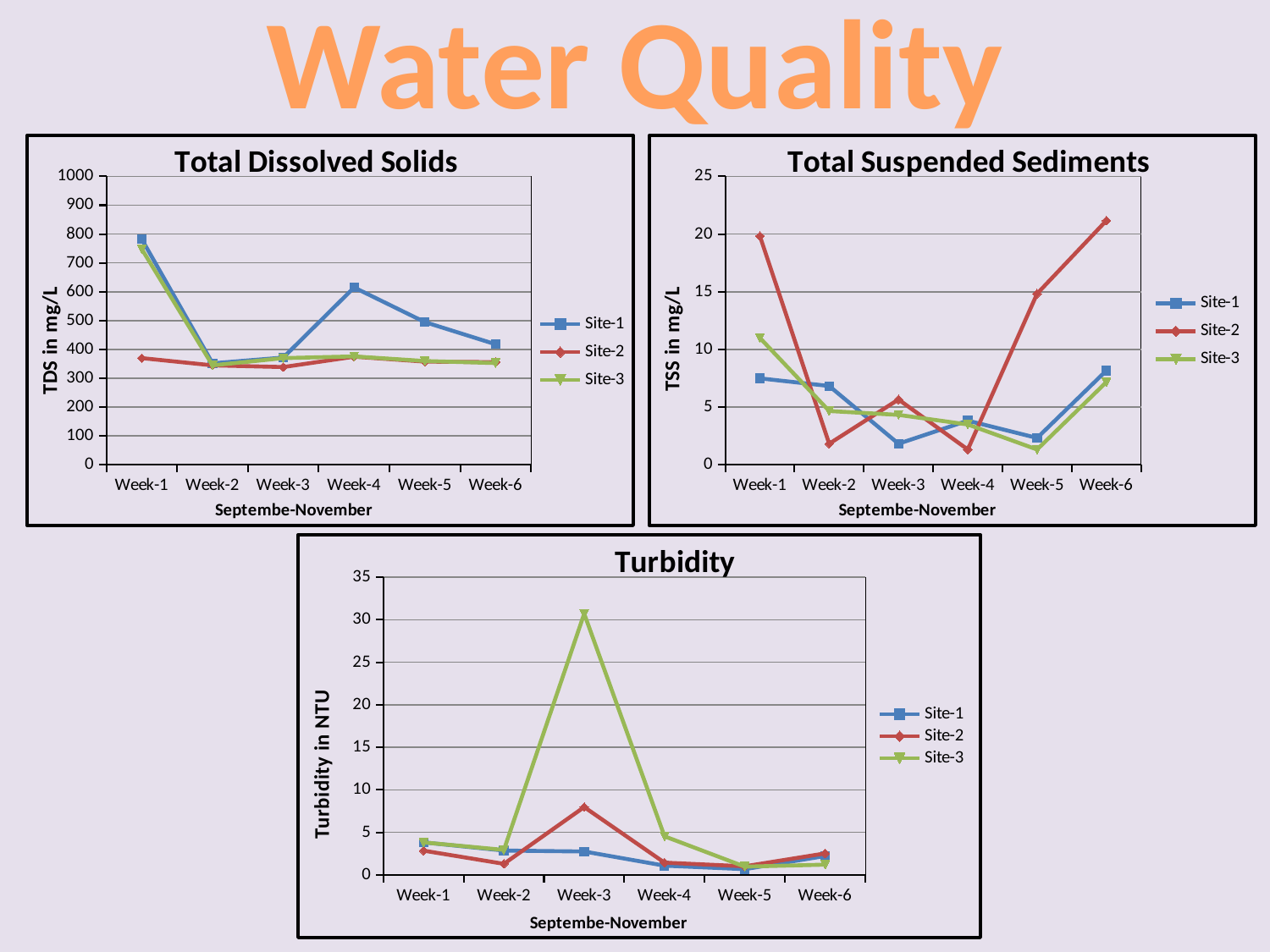
How many series does the legend of the Turbidity chart list? 3 In the Turbidity chart, is the value for Site-3 at Week-3 greater or less than 25? greater In the Total Suspended Sediments chart, is the value for Site-1 at Week-1 greater or less than 5? greater In the Total Dissolved Solids chart, at which week does Site-1 reach its highest value? Week-1 In the Turbidity chart, at which week does Site-3 reach its highest value? Week-3 In the Total Dissolved Solids chart, which is larger at Week-4, Site-1 or Site-2? Site-1 In the Total Dissolved Solids chart, is the value for Site-1 at Week-4 greater or less than 500? greater How many weeks are plotted along the x axis of the Total Suspended Sediments chart? 6 In the Total Dissolved Solids chart, do the Site-1 values rise or fall from Week-4 to Week-6? fall In the Total Suspended Sediments chart, which site has the highest value at Week-6? Site-2